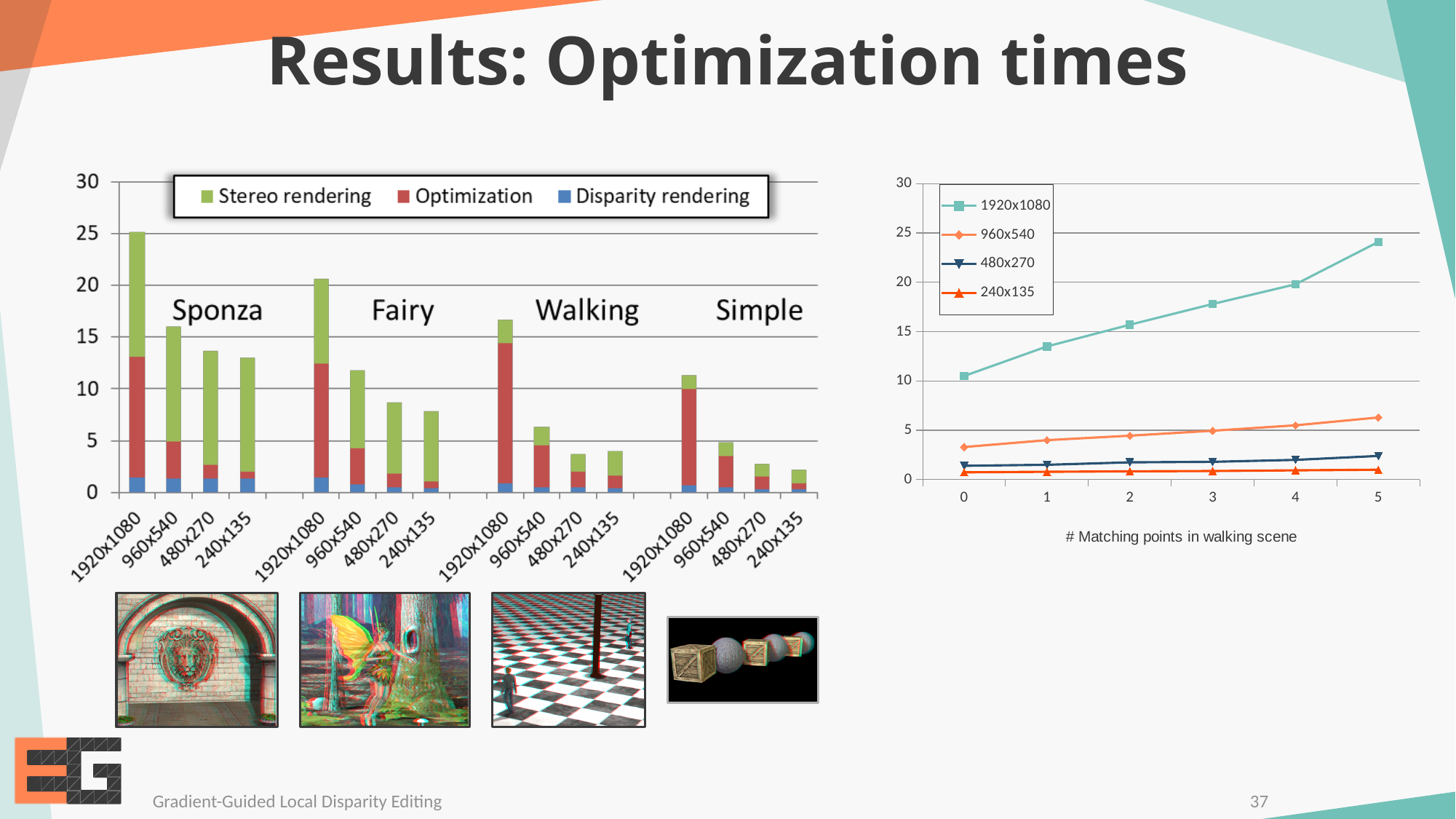
In the right line chart, does the 1920x1080 series rise or fall as the number of matching points increases from 0 to 5? rise In the right line chart, is the value of the 1920x1080 series at 5 matching points greater or less than 20? greater In the left bar chart, which bar has the smallest total height? Simple 240x135 In the left bar chart, is the total for Walking 1920x1080 greater or less than 15? greater How many series does the legend of the right line chart list? 4 What kind of chart is the right chart on the slide? line chart What kind of chart is the left chart on the slide? stacked bar chart How many series does the legend of the left bar chart list? 3 In the left bar chart, is the total for Fairy 240x135 greater or less than 10? less How many bars are plotted in the left bar chart? 16 In the left bar chart, which is taller: the Sponza 1920x1080 bar or the Simple 1920x1080 bar? Sponza 1920x1080 In the left bar chart, which bar has the greatest total height? Sponza 1920x1080